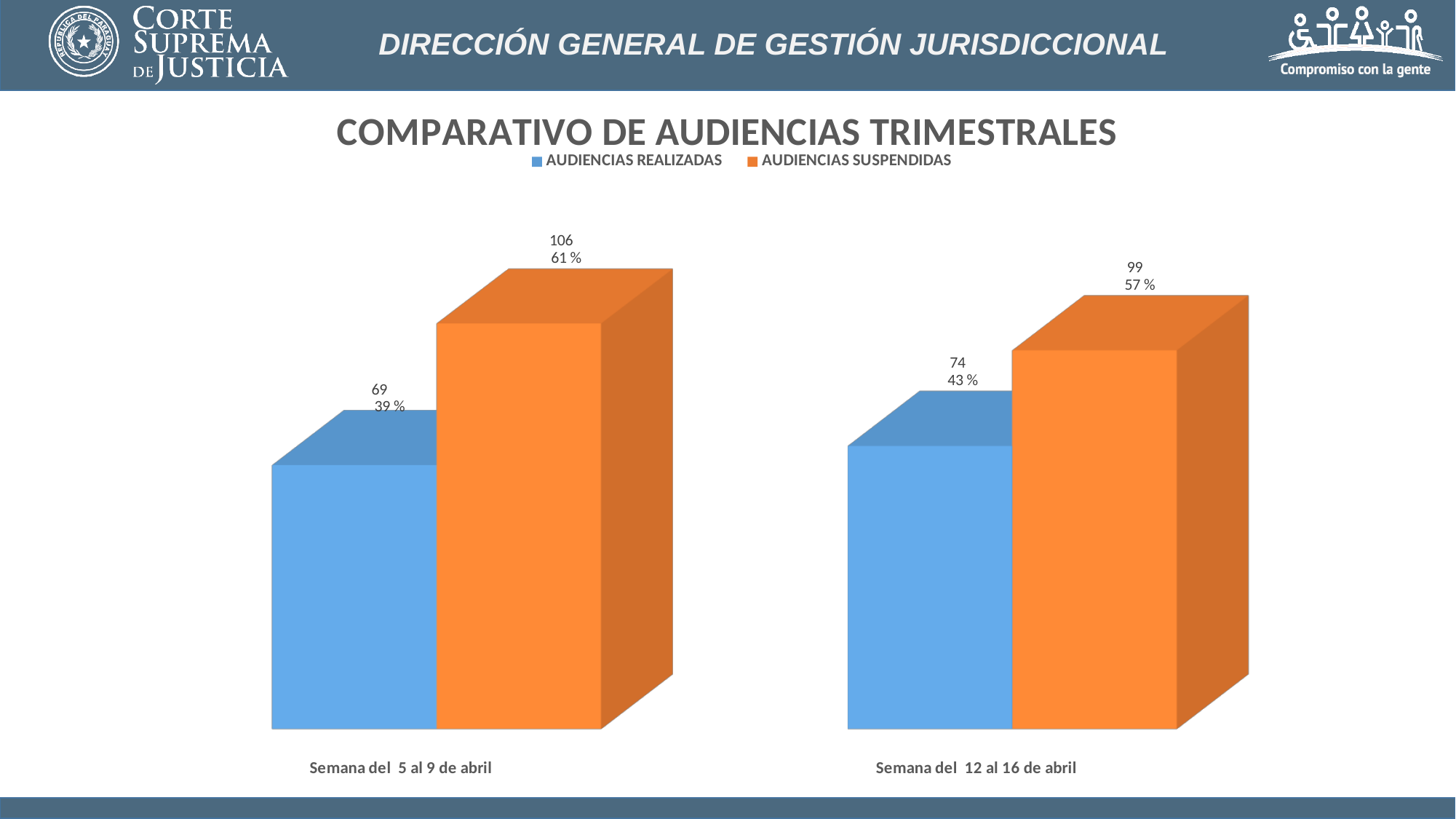
What kind of chart is shown on the slide? Bar chart What is the title of the chart? COMPARATIVO DE AUDIENCIAS TRIMESTRALES What is the value for AUDIENCIAS SUSPENDIDAS in the week 'Semana del 5 al 9 de abril'? 106 What is the value for AUDIENCIAS REALIZADAS in the week 'Semana del 5 al 9 de abril'? 69 How many series does the legend list? 2 Which is larger in the week 'Semana del 12 al 16 de abril': AUDIENCIAS REALIZADAS or AUDIENCIAS SUSPENDIDAS? AUDIENCIAS SUSPENDIDAS Which bar has the highest value on the chart? AUDIENCIAS SUSPENDIDAS, Semana del 5 al 9 de abril Which bar has the lowest value on the chart? AUDIENCIAS REALIZADAS, Semana del 5 al 9 de abril What is the difference between AUDIENCIAS SUSPENDIDAS and AUDIENCIAS REALIZADAS in the week 'Semana del 5 al 9 de abril'? 37 What percentage is shown for AUDIENCIAS SUSPENDIDAS in the week 'Semana del 12 al 16 de abril'? 57 % What is the value for AUDIENCIAS SUSPENDIDAS in the week 'Semana del 12 al 16 de abril'? 99 What is the value for AUDIENCIAS REALIZADAS in the week 'Semana del 12 al 16 de abril'? 74